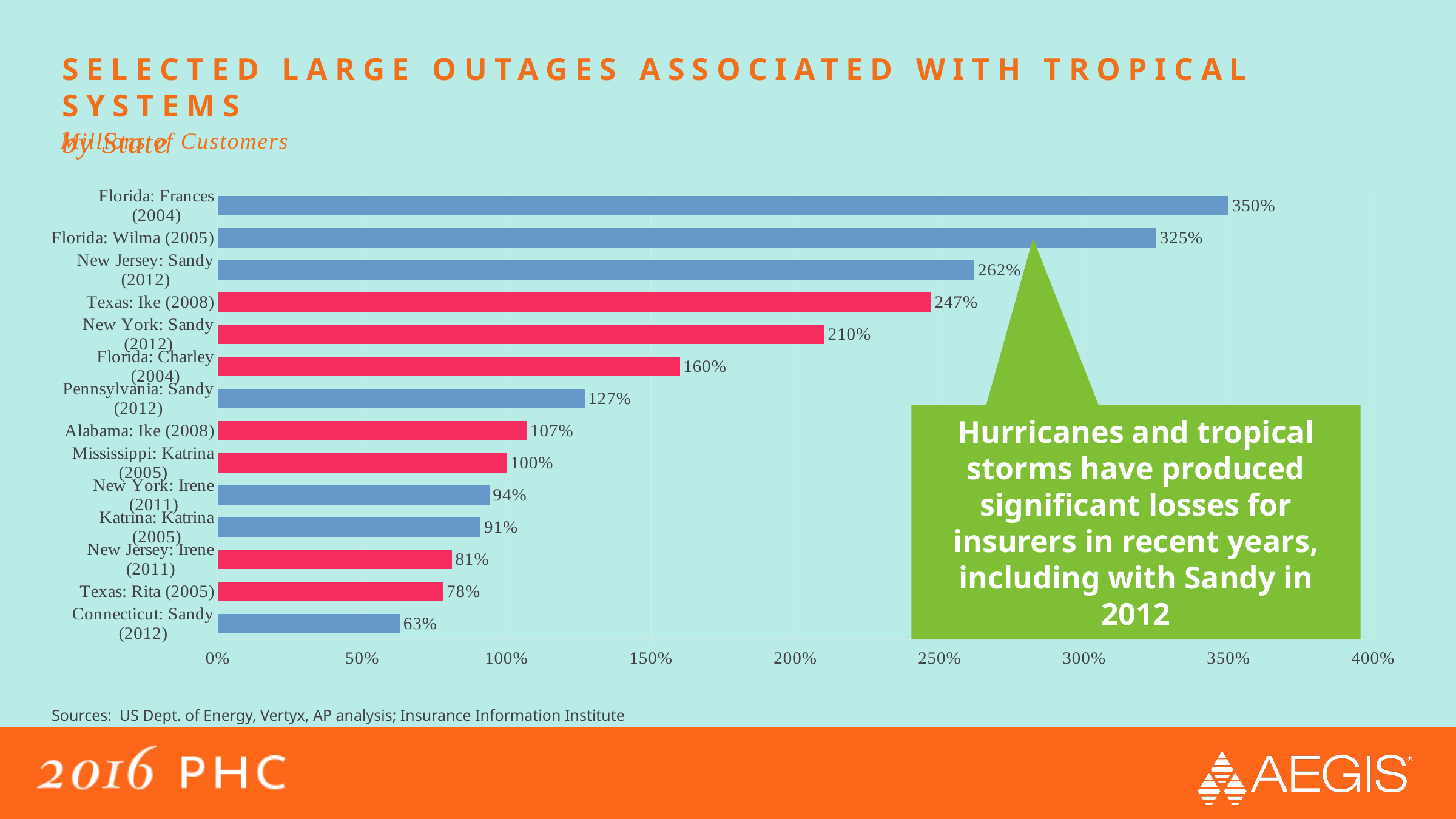
What kind of chart is shown on the slide? Bar chart Which is larger, the value for New York: Sandy (2012) or the value for Florida: Charley (2004)? New York: Sandy (2012) What is the difference between the values for Florida: Frances (2004) and Florida: Wilma (2005)? 25% Which category has the highest value? Florida: Frances (2004) Which category has the lowest value? Connecticut: Sandy (2012) What is the value for Texas: Ike (2008)? 247% What is the difference between the values for New York: Irene (2011) and New Jersey: Irene (2011)? 13% How many categories are plotted in the chart? 14 Is the value for Pennsylvania: Sandy (2012) greater or less than 150%? less What is the value for New Jersey: Sandy (2012)? 262% What is the value for Connecticut: Sandy (2012)? 63% What is the value for Florida: Frances (2004)? 350%